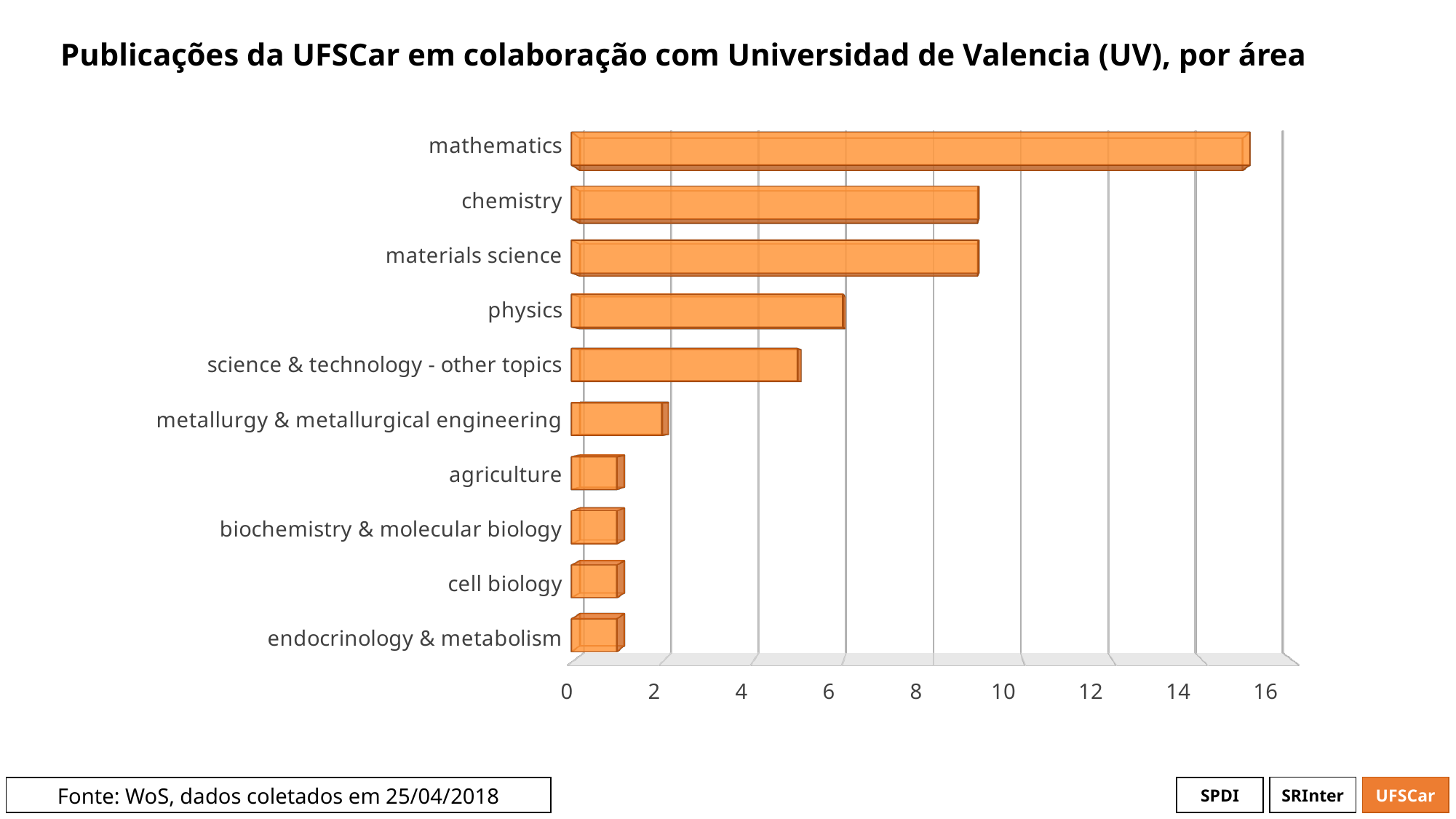
Is the value for physics greater or less than 8? less How many areas (categories) are shown in the chart? 10 What kind of chart is shown on the slide? bar chart Is the value for agriculture greater or less than 2? less Is the value for chemistry greater or less than 8? greater Which has more publications, chemistry or physics? chemistry What is the title of the chart? Publicações da UFSCar em colaboração com Universidad de Valencia (UV), por área Which has more publications, mathematics or materials science? mathematics Which area has the highest number of publications? mathematics